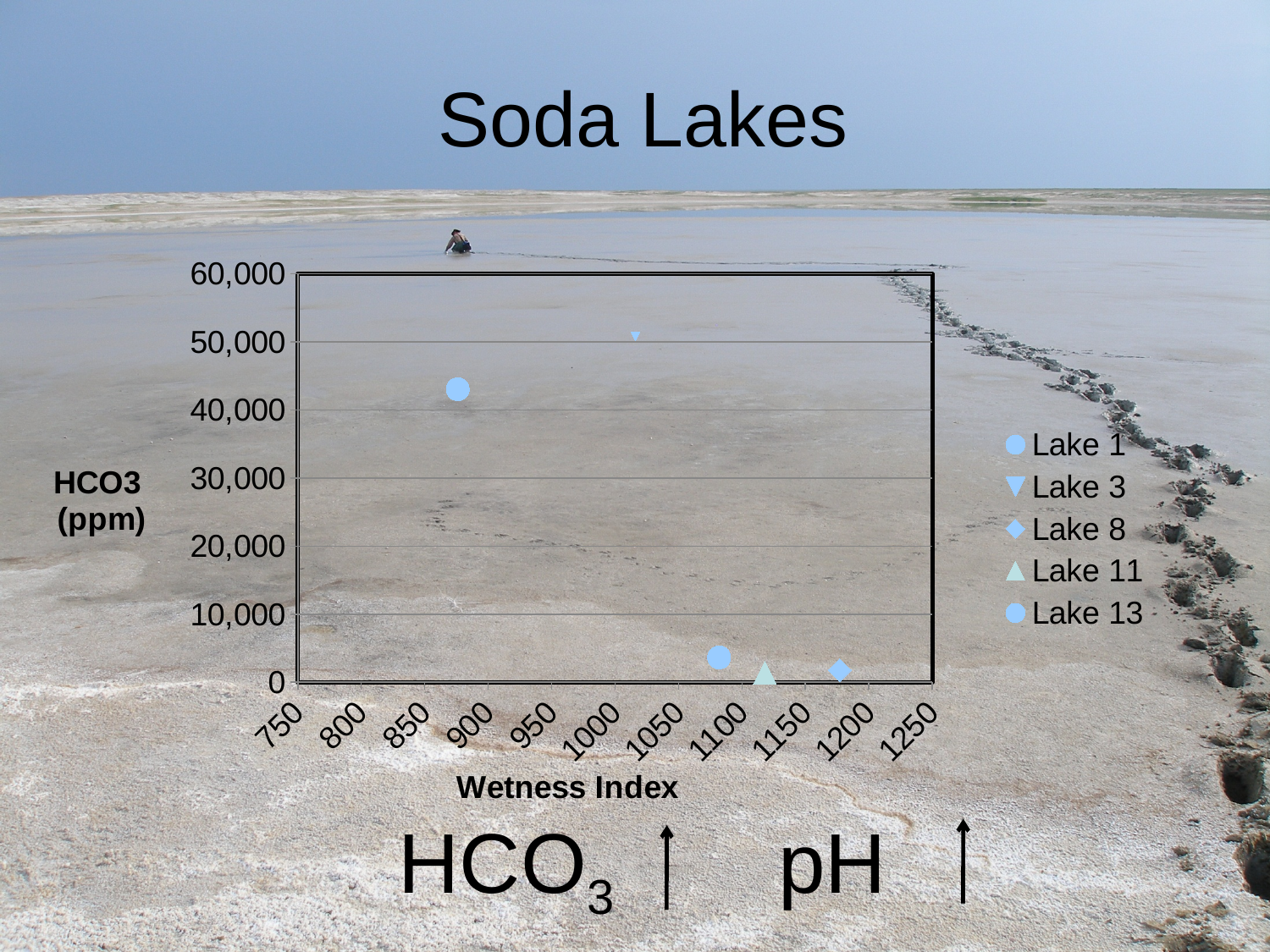
Is the Wetness Index for Lake 8 greater or less than 1150? greater Which lake has the highest HCO3 value on the chart? Lake 3 How many data points are plotted on the chart? 5 Is the HCO3 value for Lake 8 greater or less than 10,000? less How many series does the legend list? 5 Which has the higher HCO3 value, Lake 3 or Lake 8? Lake 3 Is the HCO3 value for Lake 3 greater or less than 40,000? greater What is the title of the chart slide? Soda Lakes Which has the higher HCO3 value, Lake 3 or Lake 11? Lake 3 What is the title of the x axis? Wetness Index What kind of chart is shown on the slide? scatter chart